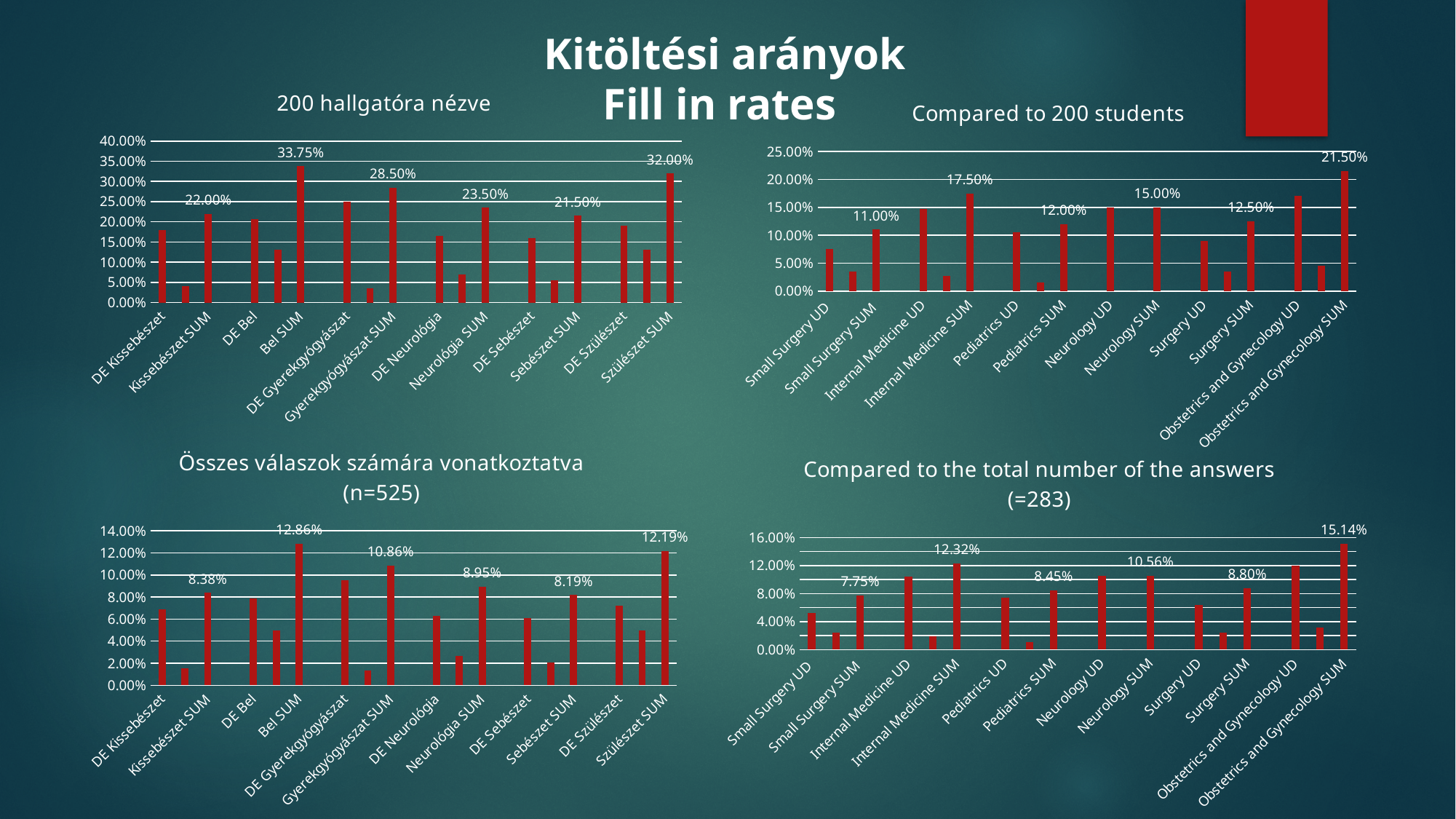
In the chart titled '200 hallgatóra nézve', what is the difference between Bel SUM and Szülészet SUM? 1.75% In the chart titled 'Compared to 200 students', what is the value for Internal Medicine SUM? 17.50% In the chart titled '200 hallgatóra nézve', what is the value for Bel SUM? 33.75% In the chart titled 'Összes válaszok számára vonatkoztatva (n=525)', is the value for DE Bel greater or less than 10.00%? less In the chart titled 'Compared to the total number of the answers (=283)', what is the value for Surgery SUM? 8.80% In the chart titled '200 hallgatóra nézve', is the value for DE Kissebészet greater or less than 15.00%? greater In the chart titled 'Compared to 200 students', which is larger: Neurology SUM or Pediatrics SUM? Neurology SUM In the chart titled 'Compared to the total number of the answers (=283)', what is the difference between Obstetrics and Gynecology SUM and Internal Medicine SUM? 2.82% In the chart titled '200 hallgatóra nézve', which category has the highest value? Bel SUM What kind of chart is the chart titled 'Compared to the total number of the answers (=283)'? bar chart In the chart titled 'Compared to 200 students', which category has the highest value? Obstetrics and Gynecology SUM In the chart titled 'Összes válaszok számára vonatkoztatva (n=525)', what is the value for Gyerekgyógyászat SUM? 10.86%